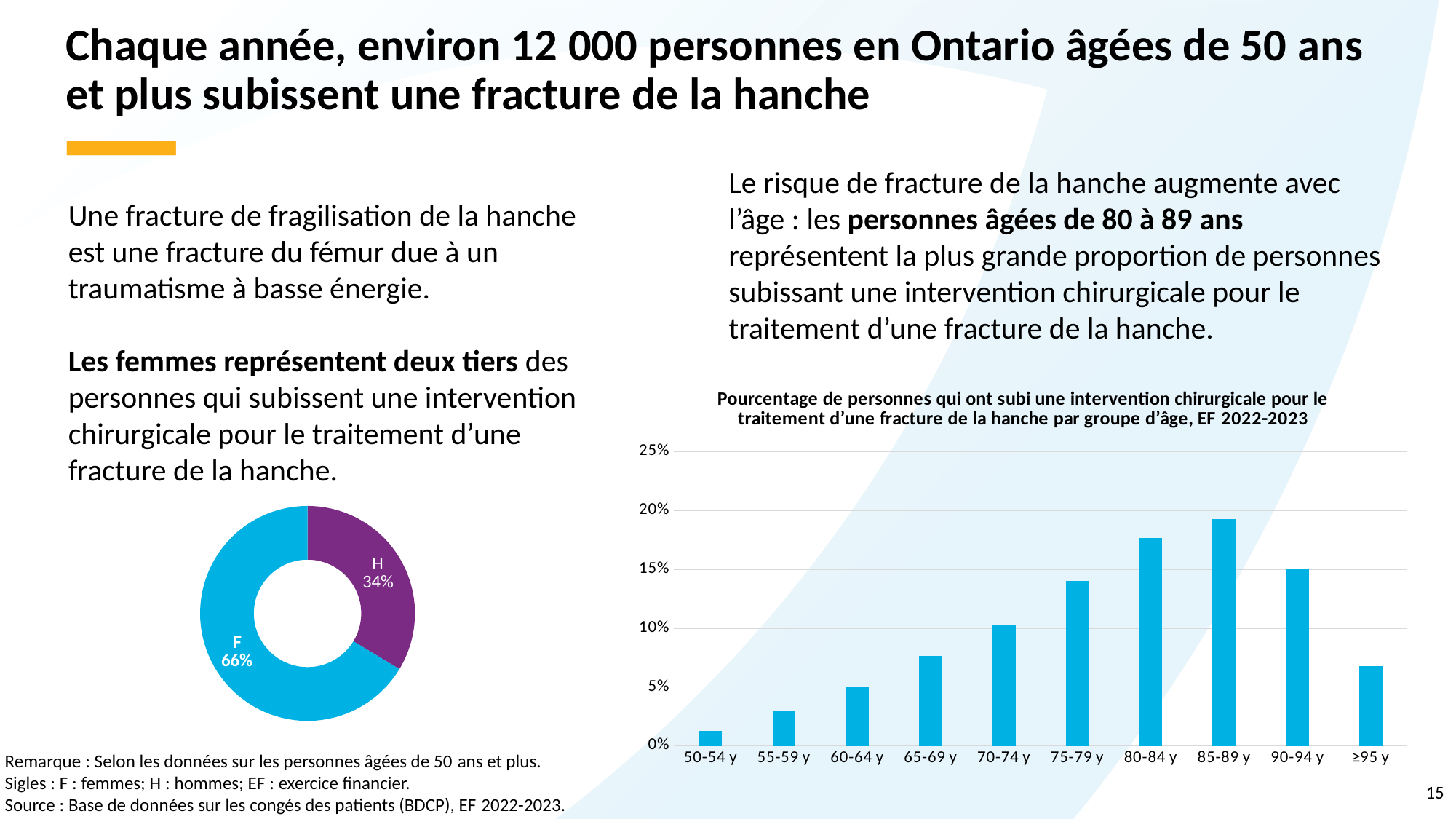
In the bar chart on the right, do the values rise or fall from 50-54 y to 85-89 y? rise In the donut chart on the left, what is the difference in percentage points between F and H? 32 percentage points In the bar chart on the right, which age group has the highest percentage? 85-89 y In the bar chart on the right, is the value for 50-54 y greater or less than 5%? less In the bar chart on the right, which age group has the lowest percentage? 50-54 y In the bar chart on the right, how many age groups are shown on the x axis? 10 In the bar chart on the right, is the value for ≥95 y greater or less than 5%? greater In the bar chart on the right, which age group has the higher value, 80-84 y or 90-94 y? 80-84 y In the bar chart on the right, is the value for 85-89 y greater or less than 15%? greater In the donut chart on the left, what percentage is shown for F (femmes)? 66% In the donut chart on the left, which group has the larger share, F or H? F In the donut chart on the left, what percentage is shown for H (hommes)? 34%